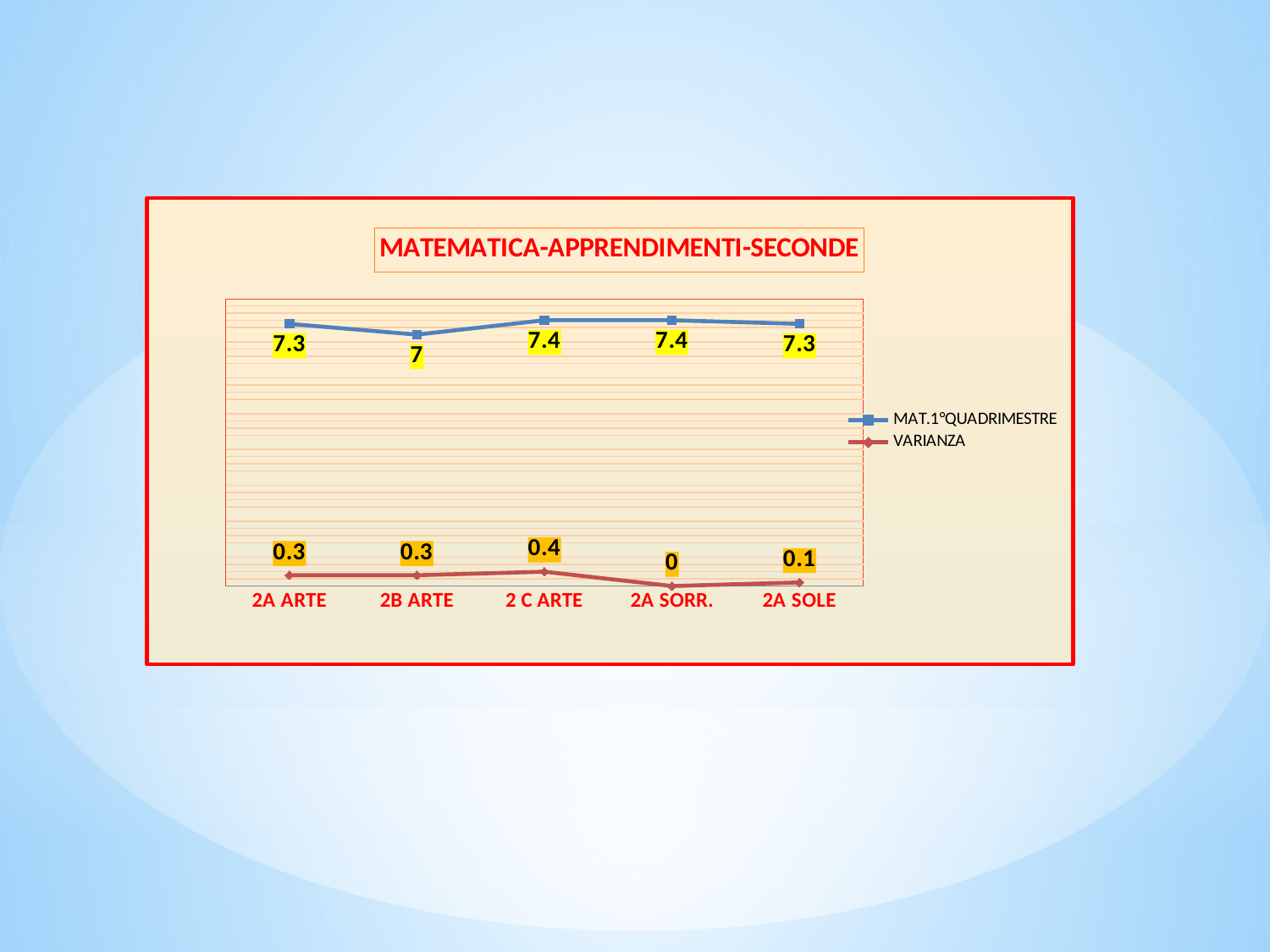
What is the difference between the MAT.1°QUADRIMESTRE values for 2 C ARTE and 2B ARTE? 0.4 What kind of chart is shown? line chart What is the MAT.1°QUADRIMESTRE value for 2A SOLE? 7.3 Which category has the highest VARIANZA value? 2 C ARTE Which is larger, the VARIANZA for 2A ARTE or for 2A SOLE? 2A ARTE What is the title of the chart? MATEMATICA-APPRENDIMENTI-SECONDE What is the VARIANZA value for 2A SORR.? 0 Which category has the lowest MAT.1°QUADRIMESTRE value? 2B ARTE What is the MAT.1°QUADRIMESTRE value for 2B ARTE? 7 How many series does the legend list? 2 How many categories are shown on the x axis? 5 What is the VARIANZA value for 2 C ARTE? 0.4